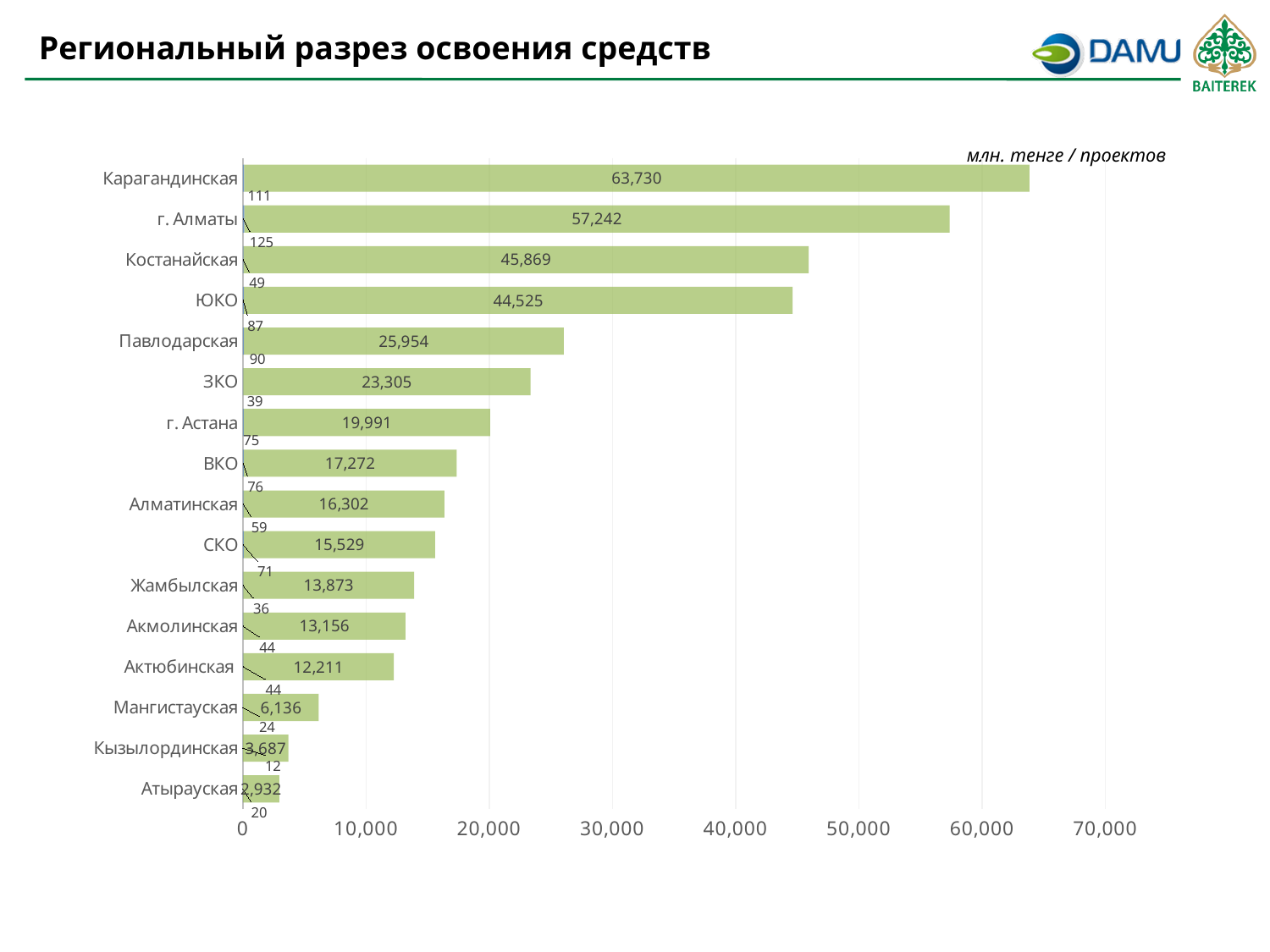
How many regions are shown in the chart? 16 What is the value for Мангистауская? 6,136 What is the title of the slide? Региональный разрез освоения средств Which region has the highest value? Карагандинская What unit label is shown above the chart? млн. тенге / проектов Which is larger, the value for Костанайская or the value for ЮКО? Костанайская What is the difference between the values for Карагандинская and г. Алматы? 6,488 Is the value for Павлодарская greater or less than 20,000? greater What kind of chart is shown on the slide? bar chart Which region has the lowest value? Атырауская What is the value for г. Астана? 19,991 What is the value for Карагандинская? 63,730